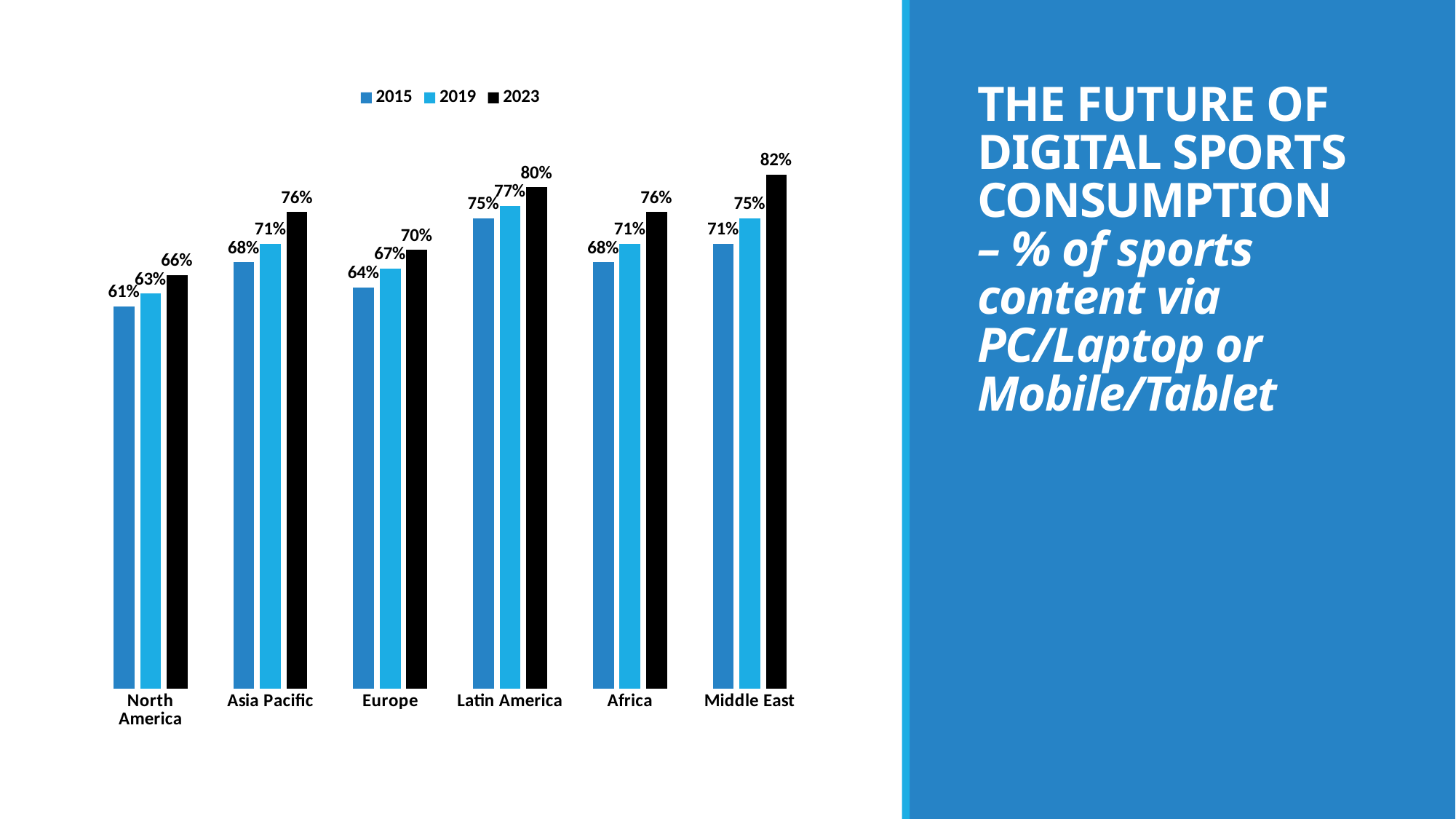
Which is larger, the 2019 value for Asia Pacific or the 2019 value for Latin America? Latin America What kind of chart is shown on the slide? Bar chart Which region has the lowest value in 2015? North America What is the difference between the 2023 and 2015 values for Middle East? 11% How many regions are shown on the x axis? 6 What is the value for Middle East in 2023? 82% Do the values for North America rise or fall from 2015 to 2023? Rise What is the difference between the 2023 values for Latin America and Europe? 10% How many series does the legend list? 3 What is the value for Europe in 2015? 64% What is the value for Latin America in 2019? 77% Which region has the highest value in 2023? Middle East